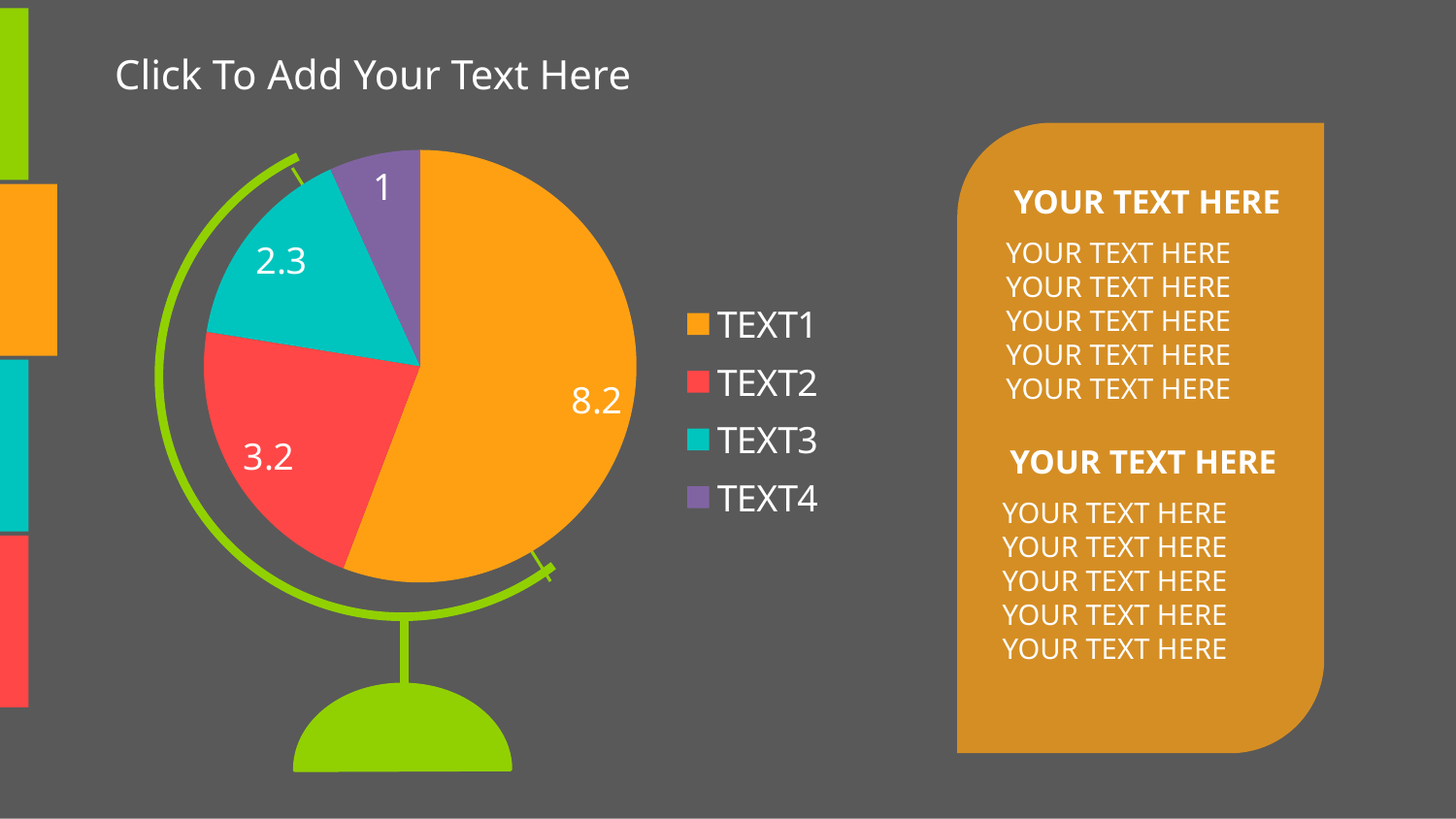
What is the value of the TEXT2 slice in the pie chart? 3.2 Which category has the largest slice in the pie chart? TEXT1 What is the difference between the values of TEXT3 and TEXT4? 1.3 Which category has the smallest slice in the pie chart? TEXT4 What kind of chart is shown on the slide? Pie chart What colour is the TEXT3 slice in the pie chart? Teal What is the value of the TEXT4 slice in the pie chart? 1 What is the difference between the values of TEXT1 and TEXT2? 5 What is the value of the TEXT1 slice in the pie chart? 8.2 Which is larger, the value for TEXT2 or the value for TEXT3? TEXT2 What is the value of the TEXT3 slice in the pie chart? 2.3 How many slices does the pie chart have? 4